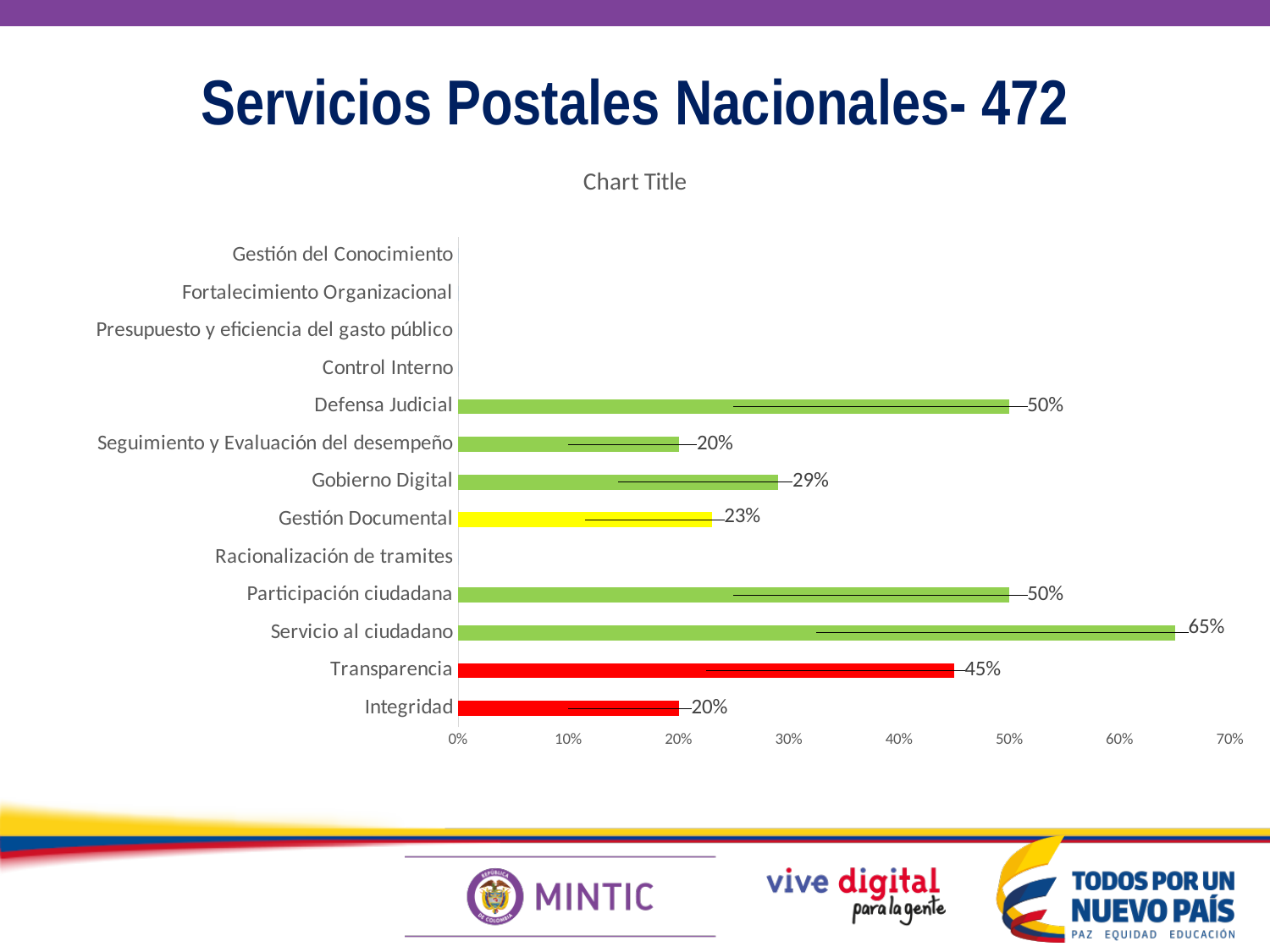
What is the value for Servicio al ciudadano? 65% What is the difference between the values for Servicio al ciudadano and Transparencia? 20% What kind of chart is shown on the slide? bar chart Which is larger, the value for Defensa Judicial or the value for Gobierno Digital? Defensa Judicial What is the value for Transparencia? 45% How many categories are listed on the vertical axis? 13 What is the value for Gobierno Digital? 29% What colour is the bar for Gestión Documental? yellow Which category has the highest value? Servicio al ciudadano What is the value for Gestión Documental? 23% What is the difference between the values for Gobierno Digital and Gestión Documental? 6% Is the value for Transparencia greater or less than 40%? greater